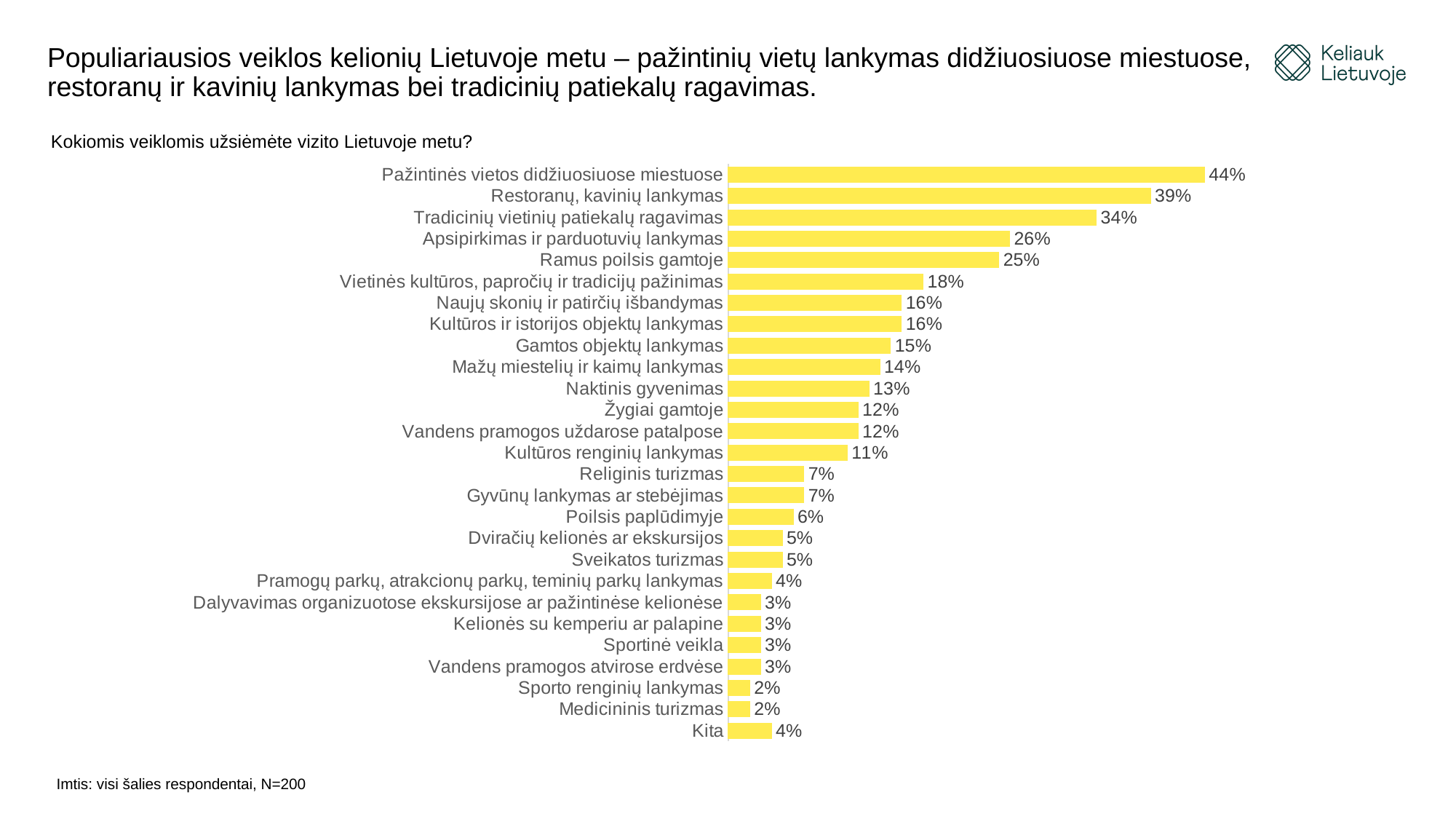
What is the difference in percentage points between "Pažintinės vietos didžiuosiuose miestuose" and "Apsipirkimas ir parduotuvių lankymas"? 18 What percentage of respondents chose "Pažintinės vietos didžiuosiuose miestuose"? 44% Which has a larger value: "Žygiai gamtoje" or "Kultūros renginių lankymas"? Žygiai gamtoje Which has a larger value: "Religinis turizmas" or "Poilsis paplūdimyje"? Religinis turizmas Which activity has the highest percentage on the chart? Pažintinės vietos didžiuosiuose miestuose How many activity categories are listed on the chart? 27 What percentage is shown for "Naktinis gyvenimas"? 13% What is the value shown for "Ramus poilsis gamtoje"? 25% What type of chart is shown on the slide? Bar chart What colour are the bars in the chart? Yellow What is the difference in percentage points between "Restoranų, kavinių lankymas" and "Tradicinių vietinių patiekalų ragavimas"? 5 What is the value for "Kita"? 4%